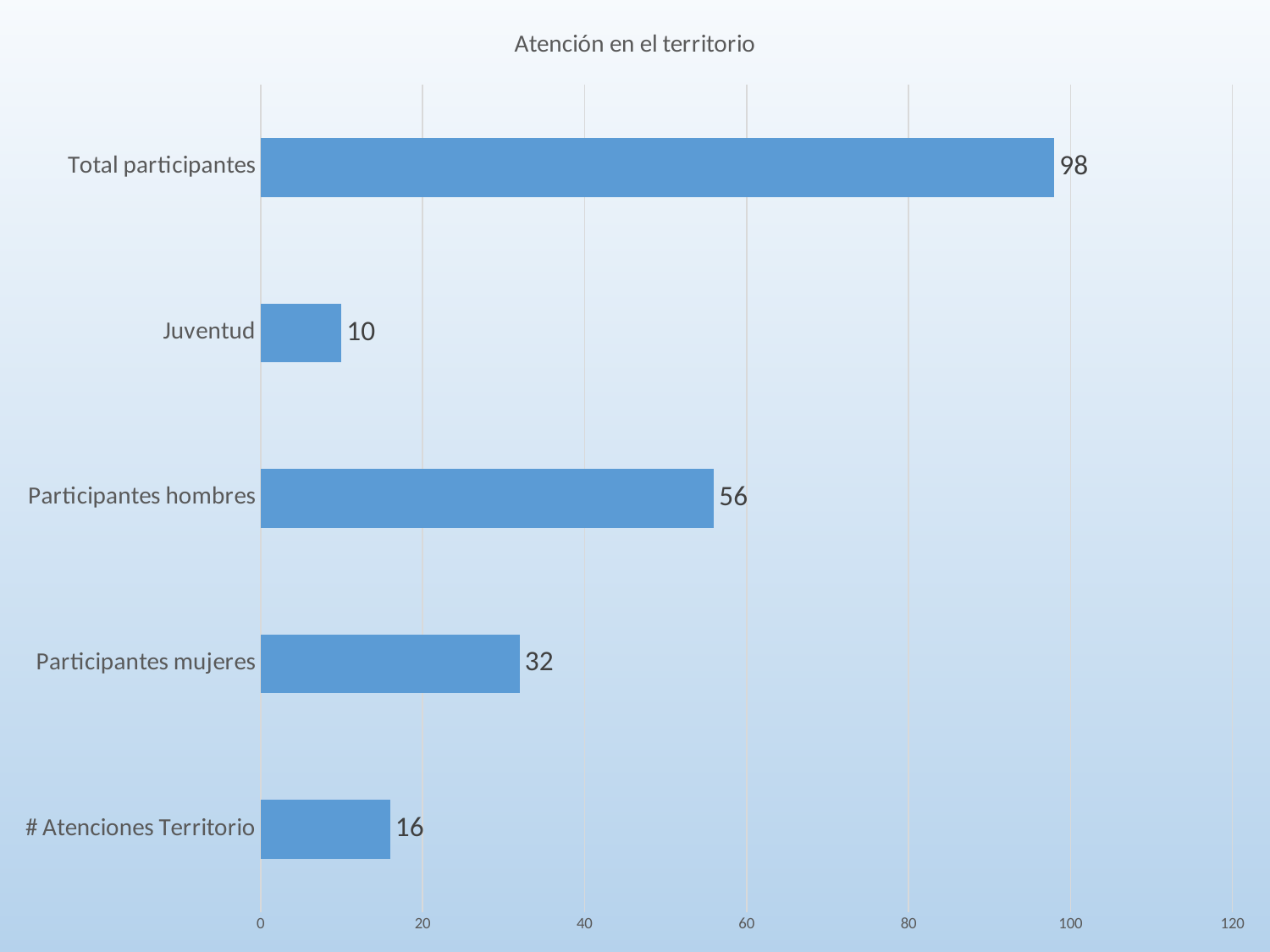
What kind of chart is this? bar chart What is the difference between Participantes hombres and Participantes mujeres? 24 What is the value for Total participantes? 98 What is the title of the chart? Atención en el territorio What is the value for Juventud? 10 What is the value for # Atenciones Territorio? 16 Which category has the lowest value? Juventud What is the value for Participantes hombres? 56 Is the value for Participantes hombres greater or less than 60? less Which is larger, Participantes mujeres or # Atenciones Territorio? Participantes mujeres How many categories are shown in the chart? 5 Which category has the highest value? Total participantes